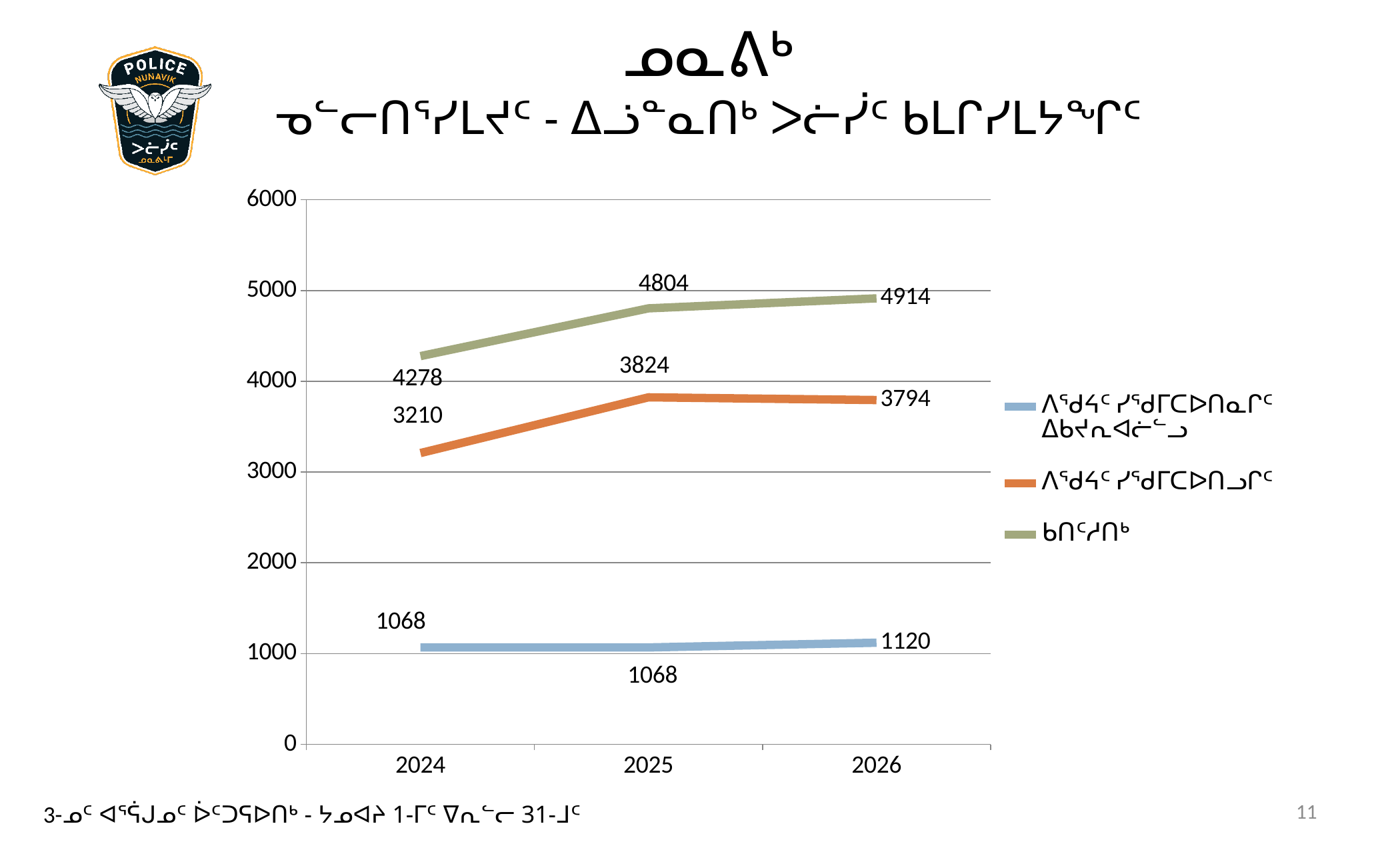
What is the difference between the orange series values in 2025 and 2026? 30 What is the value of the blue series in 2026? 1120 In which year does the green series reach its highest value? 2026 How many series does the legend list? 3 What is the value of the orange series in 2024? 3210 For the orange series, which year has the larger value, 2025 or 2026? 2025 What is the value of the green series in 2026? 4914 What kind of chart is shown on the slide? line chart Is the value of the blue series in 2025 greater or less than 2000? less By how much did the green series increase from 2024 to 2025? 526 Does the green series rise or fall from 2024 to 2026? rises How many years are shown on the x axis? 3